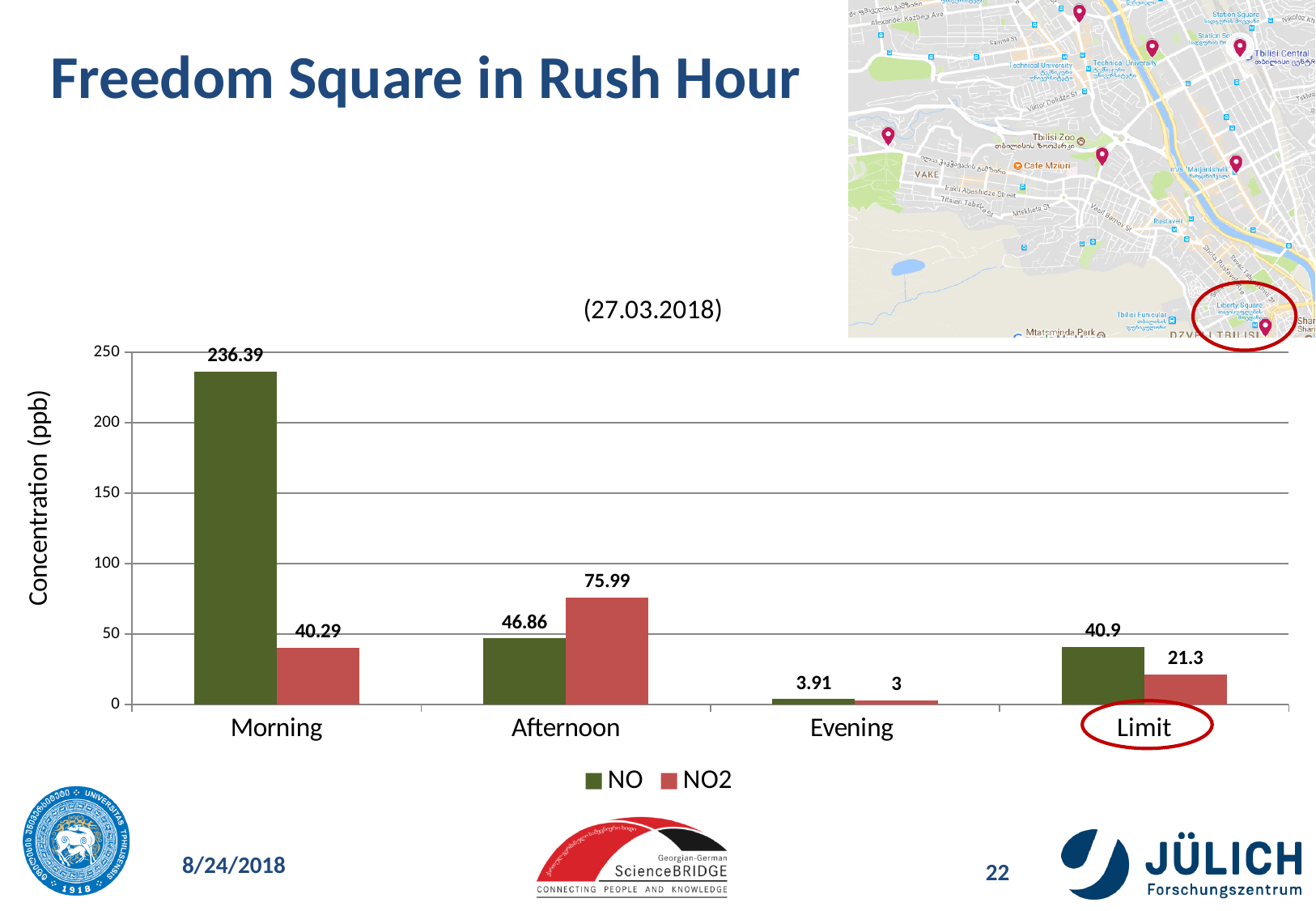
What is the label of the y axis? Concentration (ppb) What kind of chart is shown on the slide? bar chart What is the NO concentration in the Morning? 236.39 What is the difference between the NO and NO2 concentrations in the Morning? 196.1 In the Afternoon, which is larger, the NO or the NO2 concentration? NO2 Which category has the highest NO concentration? Morning Is the NO concentration in the Morning greater or less than 200? greater Which category has the lowest NO2 concentration? Evening What is the NO2 value shown for the Limit category? 21.3 What is the NO2 concentration in the Afternoon? 75.99 How many categories are shown on the x axis? 4 How many series does the legend list? 2